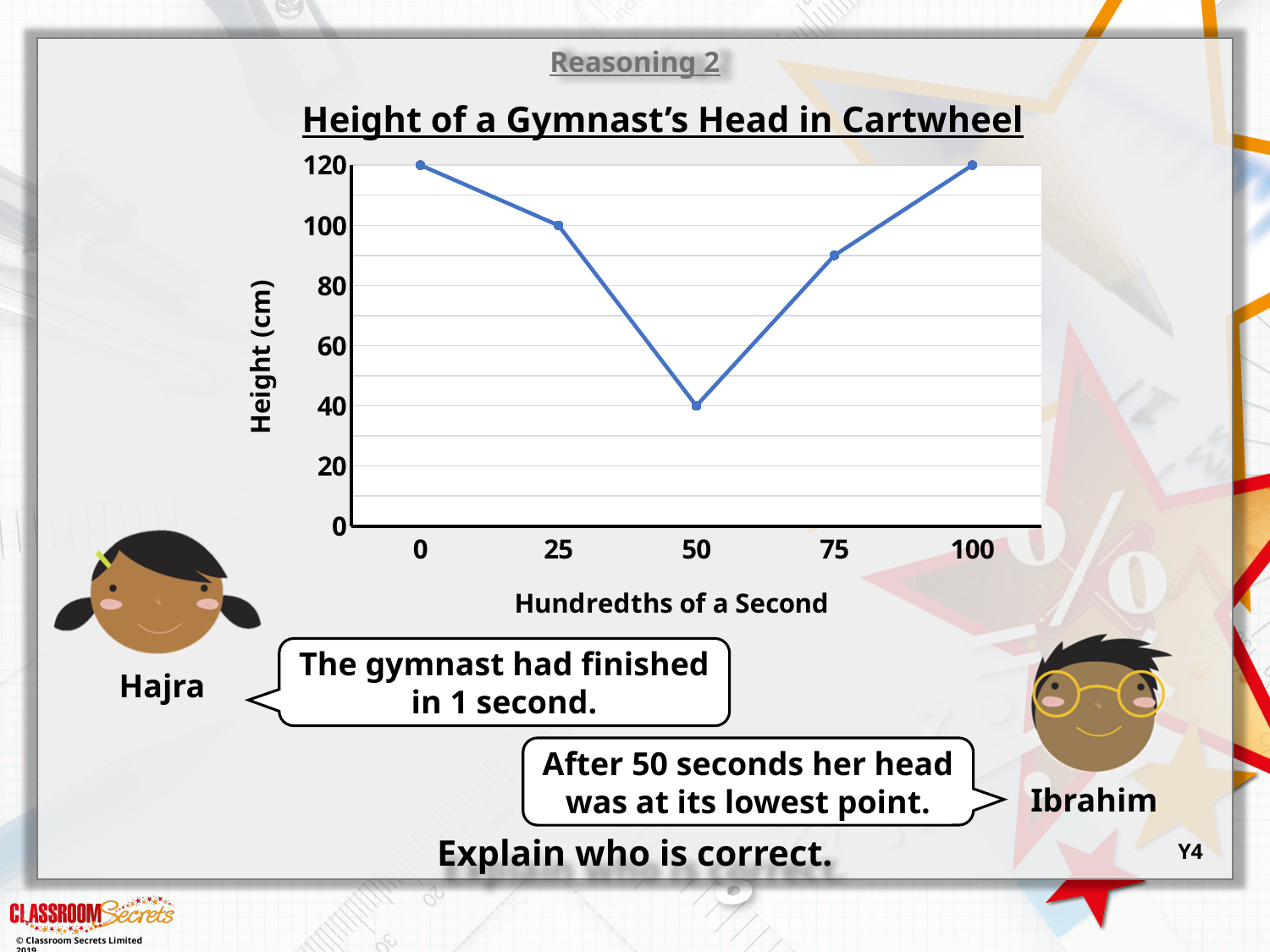
Is the height at 75 hundredths of a second greater or less than 80? greater What is the height at 0 hundredths of a second? 120 What is the height at 50 hundredths of a second? 40 What kind of chart is shown? line chart What is the difference between the height at 25 and the height at 50 hundredths of a second? 60 Which has the greater height: 25 or 50 hundredths of a second? 25 How many data points are plotted on the chart? 5 What is the height at 100 hundredths of a second? 120 What is the height at 25 hundredths of a second? 100 Does the height rise or fall between 0 and 50 hundredths of a second? fall What is the difference between the height at 0 and the height at 50 hundredths of a second? 80 At which time (in hundredths of a second) is the height lowest? 50